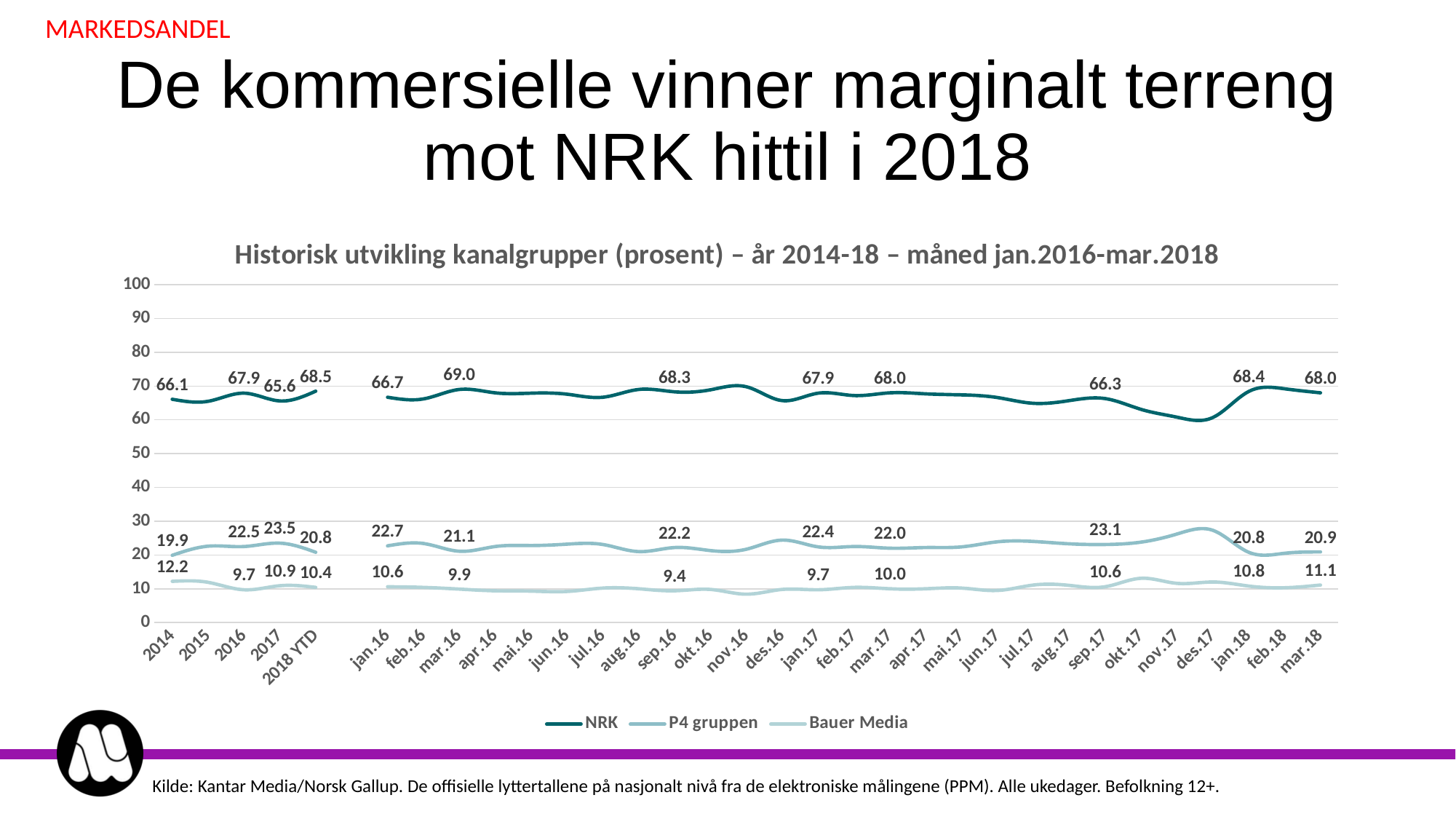
What is the P4 gruppen value for sep.17? 23.1 What kind of chart is shown on the slide? line chart What is the NRK value for mar.16? 69.0 Is the NRK value for des.17 greater or less than 70? less How many series does the legend list? 3 Which series are listed in the legend? NRK, P4 gruppen, Bauer Media Which is larger for Bauer Media: the value for jan.16 or the value for mar.18? mar.18 What is the NRK value for 2018 YTD? 68.5 What is the difference between the P4 gruppen value for jan.16 and for mar.18? 1.8 Among the labelled monthly points, which month has the highest NRK value? mar.16 What is the difference between the NRK value and the P4 gruppen value for mar.18? 47.1 What is the Bauer Media value for mar.18? 11.1